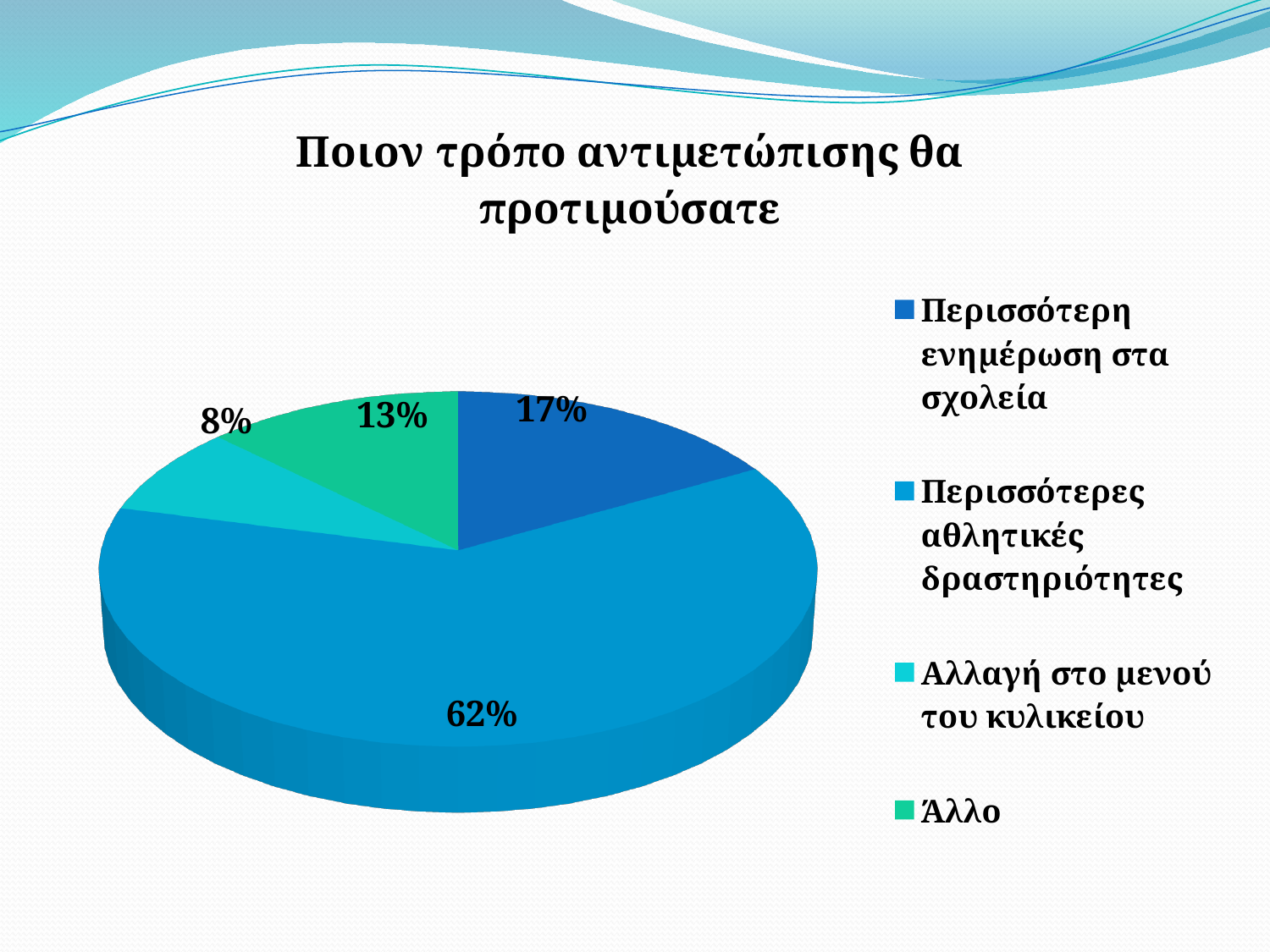
What kind of chart is shown on the slide? Pie chart Which category has the largest slice of the pie? Περισσότερες αθλητικές δραστηριότητες What share of the pie does Άλλο have? 13% What is the title of the chart? Ποιον τρόπο αντιμετώπισης θα προτιμούσατε How many categories does the pie chart show? 4 What share of the pie does Αλλαγή στο μενού του κυλικείου have? 8% What is the difference in percentage points between Περισσότερες αθλητικές δραστηριότητες and Περισσότερη ενημέρωση στα σχολεία? 45 percentage points Which legend entry is shown in green? Άλλο Which category has the smallest slice of the pie? Αλλαγή στο μενού του κυλικείου What share of the pie does Περισσότερη ενημέρωση στα σχολεία have? 17% Which is larger, the slice for Άλλο or the slice for Αλλαγή στο μενού του κυλικείου? Άλλο